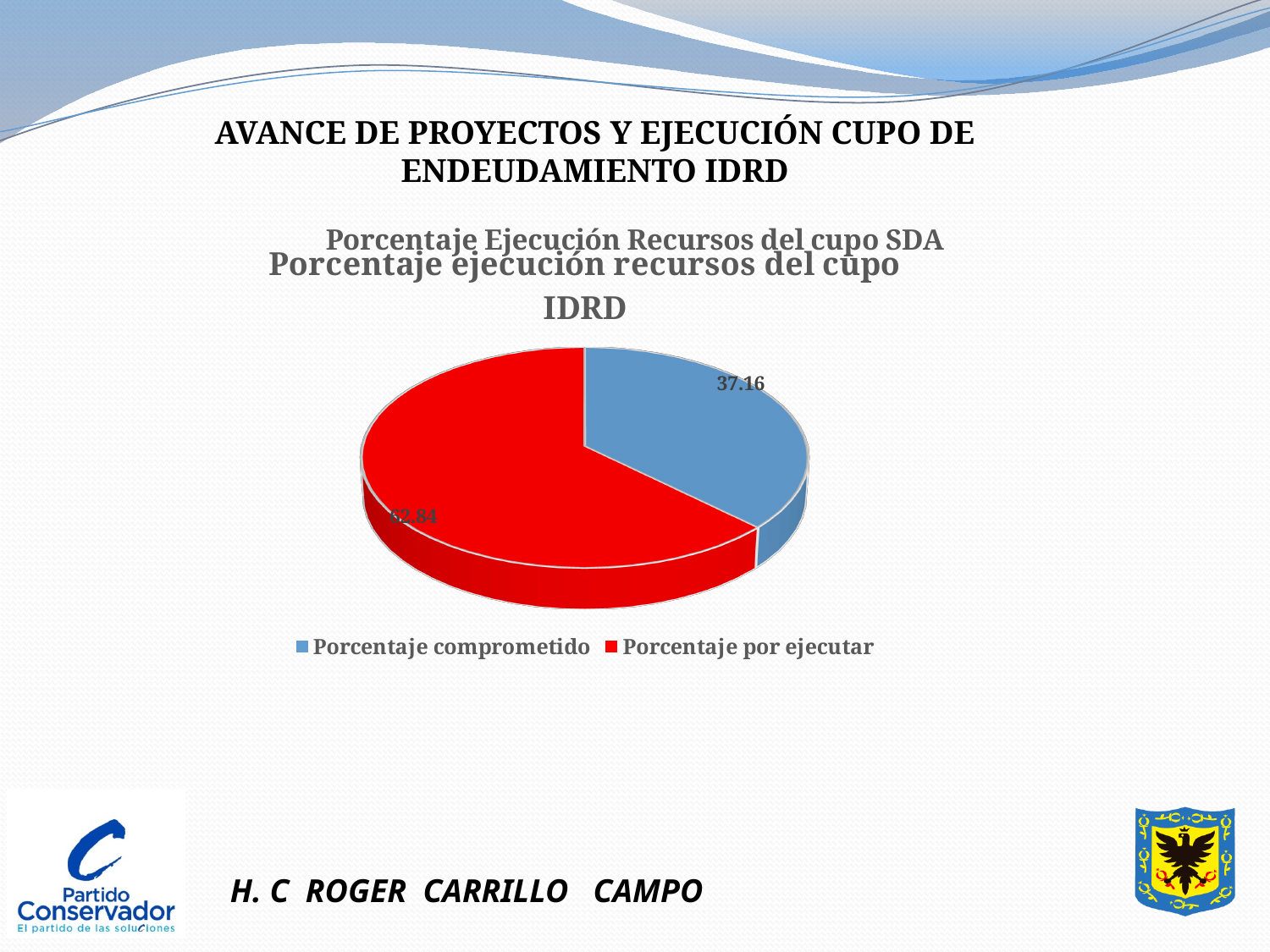
What colour is the Porcentaje comprometido slice? blue How many slices does the pie chart have? 2 What is the difference between Porcentaje por ejecutar and Porcentaje comprometido? 25.68 Which slice is the largest? Porcentaje por ejecutar Which is larger, Porcentaje comprometido or Porcentaje por ejecutar? Porcentaje por ejecutar What is the value for Porcentaje comprometido? 37.16 What is the value for Porcentaje por ejecutar? 62.84 How many entries does the legend list? 2 Which slice is the smallest? Porcentaje comprometido What kind of chart is shown on the slide? pie chart What colour is the Porcentaje por ejecutar slice? red